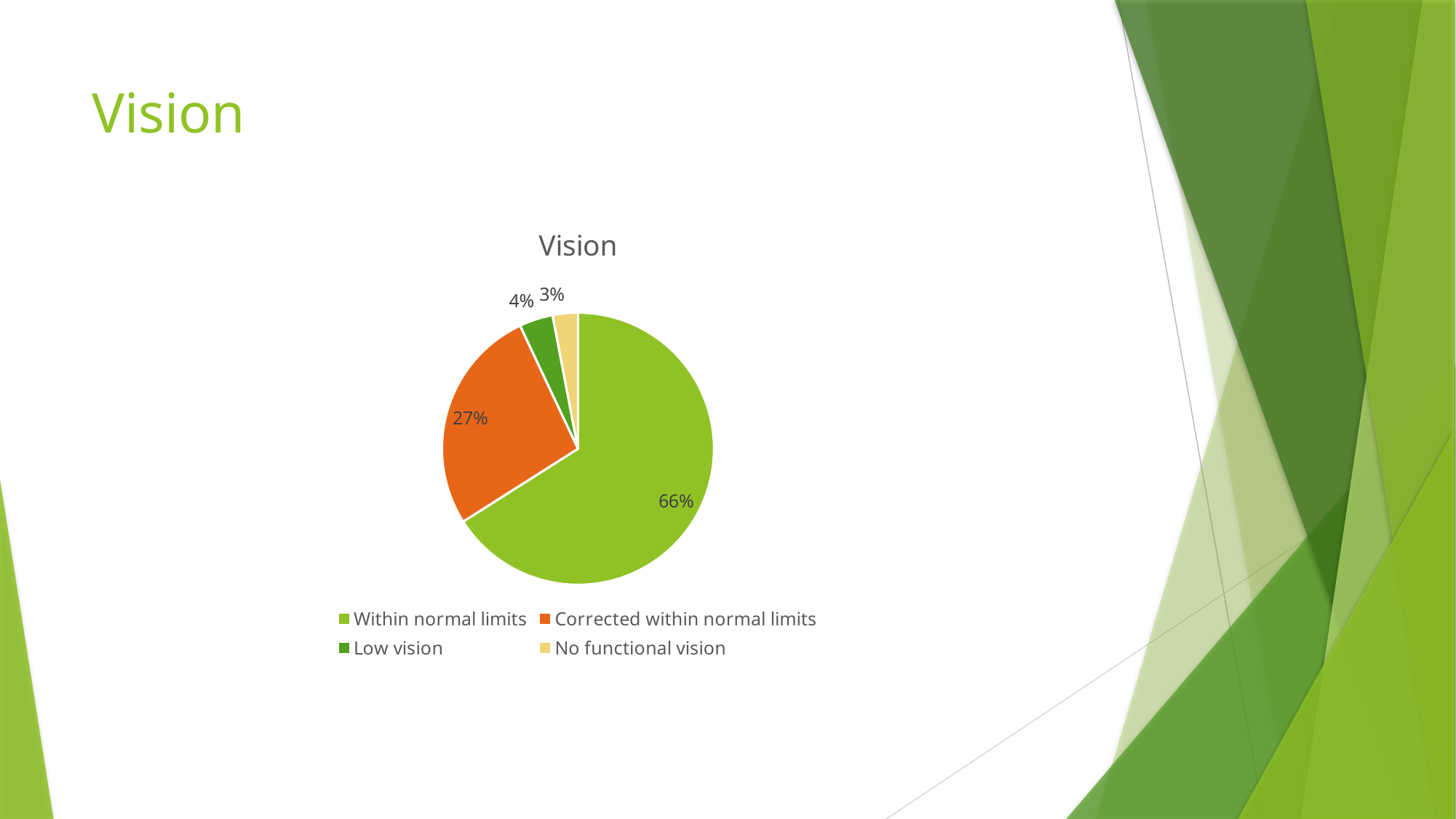
What percentage of the pie is Within normal limits? 66% What percentage of the pie is Corrected within normal limits? 27% Which category has the largest slice of the pie? Within normal limits What is the difference in percentage points between Within normal limits and Corrected within normal limits? 39 Which category has the smallest slice of the pie? No functional vision What colour is the Corrected within normal limits slice? orange What is the title of the chart? Vision What percentage of the pie is No functional vision? 3% Which is larger, the Low vision slice or the No functional vision slice? Low vision What kind of chart is shown on the slide? pie chart What percentage of the pie is Low vision? 4% How many categories does the pie chart have? 4